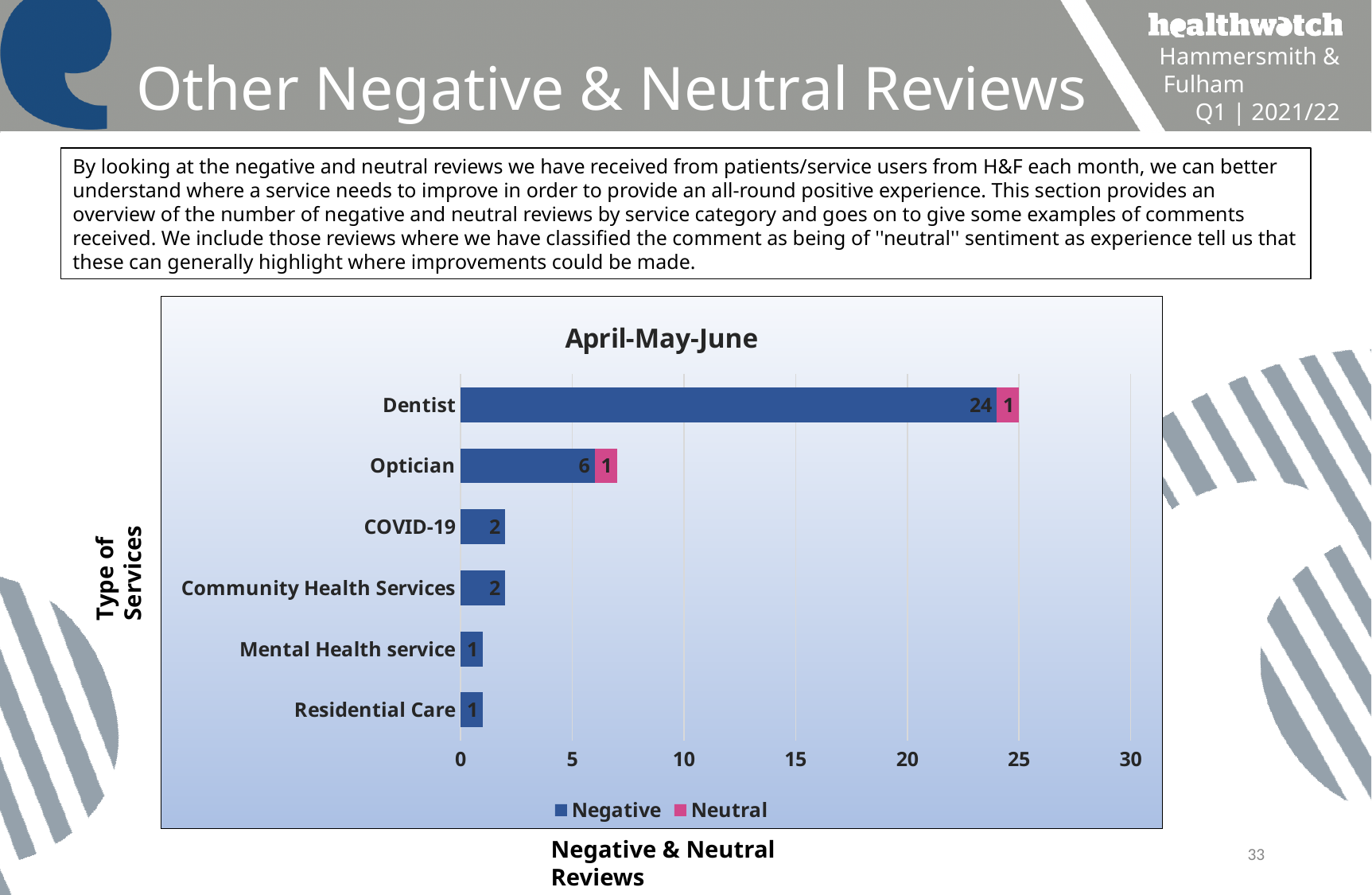
How many series does the legend list? 2 What kind of chart is shown? Stacked bar chart What is the Negative value for COVID-19? 2 How many service categories are shown on the chart? 6 What is the Negative value for Dentist? 24 What is the difference between the Negative values for Dentist and Optician? 18 Which is larger, the Negative value for Optician or for Community Health Services? Optician What is the Neutral value for Optician? 1 What is the title of the chart? April-May-June Is the Negative value for Dentist greater or less than 20? greater Which category has the highest Negative value? Dentist What is the total of the stacked bar for Dentist? 25